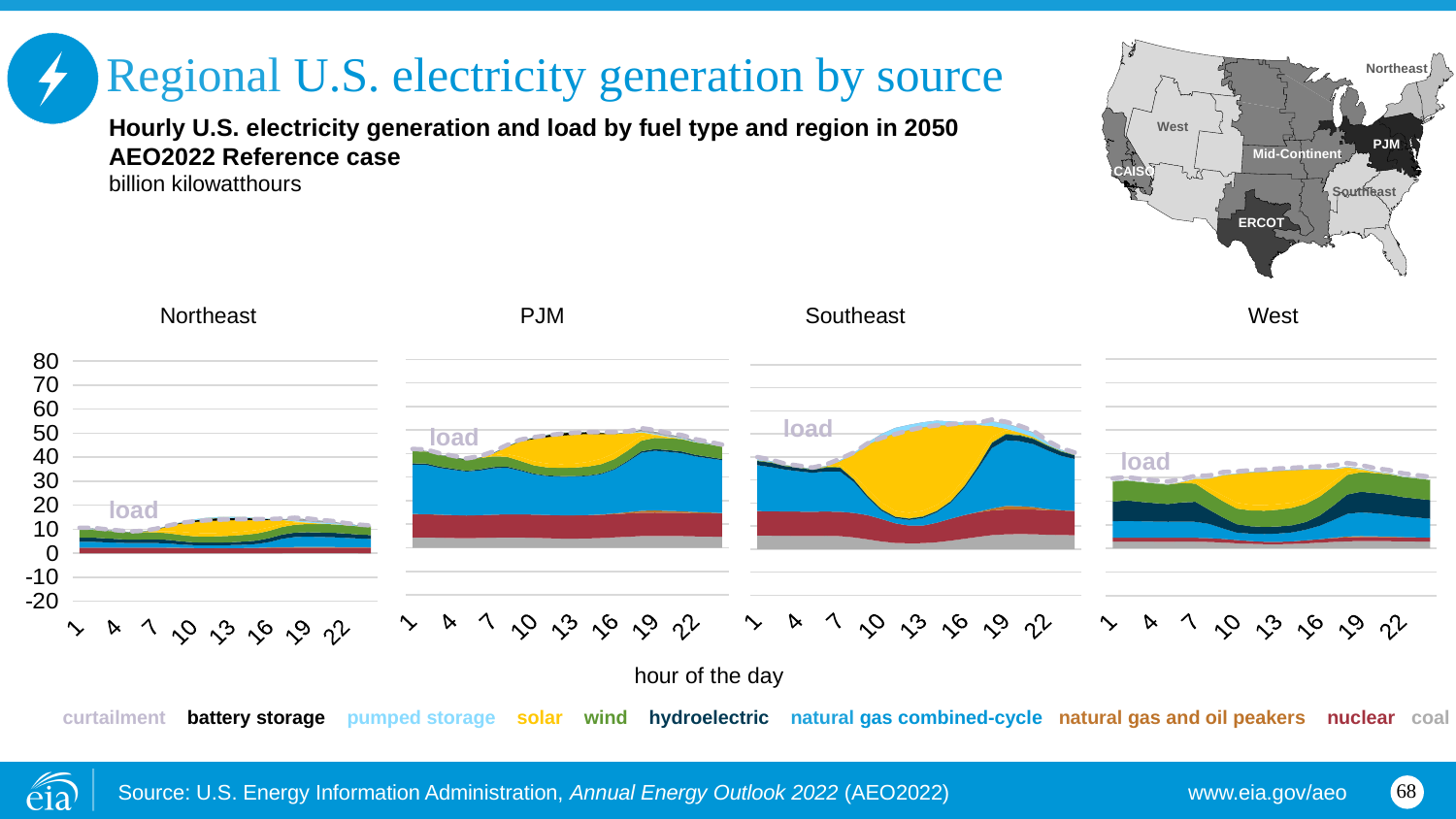
How many hour tick labels are shown along the x axis of each chart? 8 How many regional charts are shown on the slide? 4 Which region's chart shows the lowest load throughout the day? Northeast In the West chart, is the peak load value greater or less than 30? greater In the Northeast chart, is the peak load value greater or less than 20? less What kind of chart is used for each of the four regional panels on the slide? stacked area chart Which has the higher peak load, the Southeast chart or the Northeast chart? Southeast What unit is given for the values plotted in the charts? billion kilowatthours In the Southeast chart, does the solar area grow or shrink between hour 7 and hour 13? grow How many fuel-type entries does the legend at the bottom of the slide list? 10 In the PJM chart, is the load value at hour 1 greater or less than 40? greater